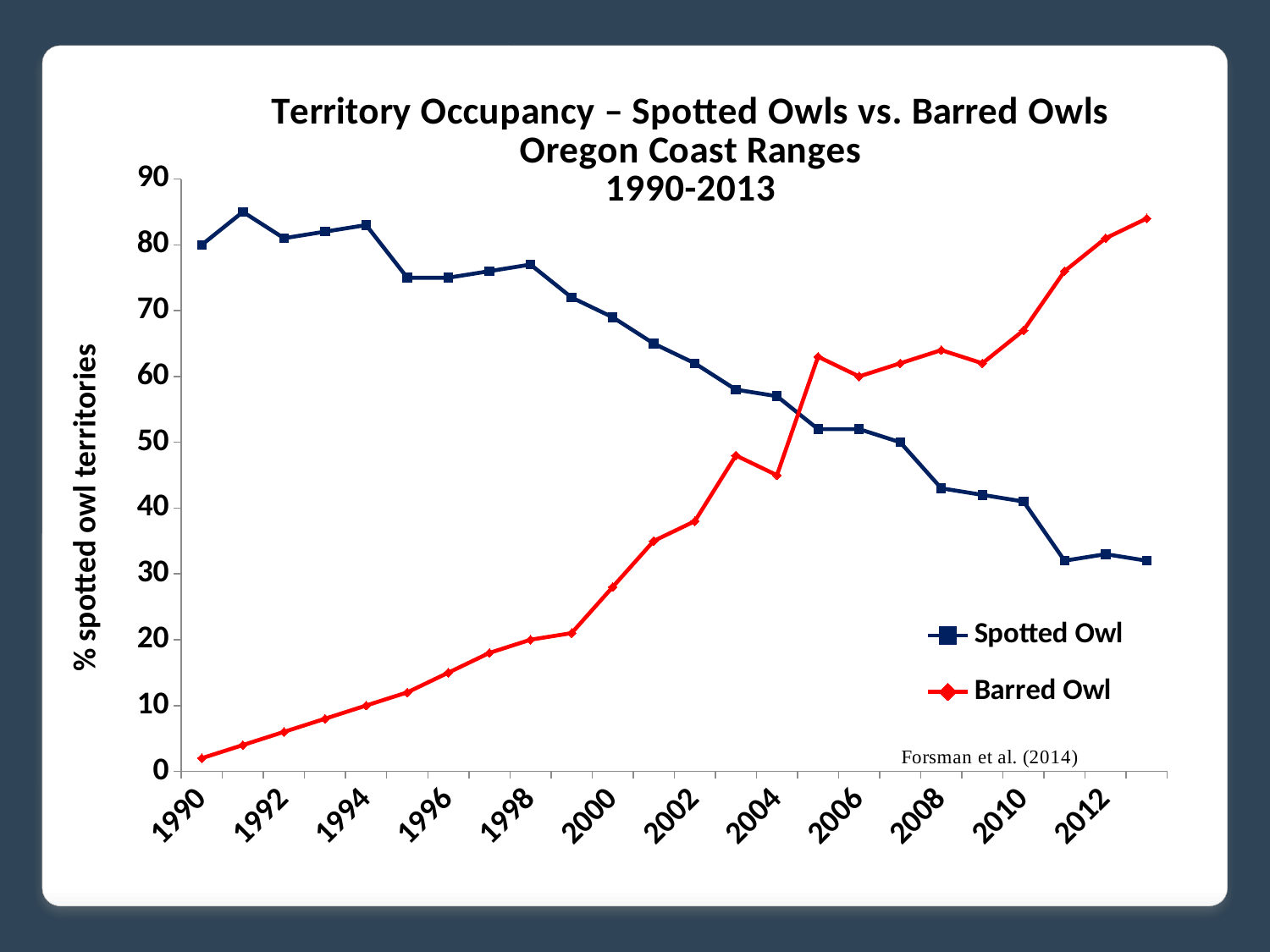
What is the title of the chart? Territory Occupancy – Spotted Owls vs. Barred Owls Oregon Coast Ranges 1990-2013 Does the Barred Owl series rise or fall from 1990 to 2013? rise Is the Barred Owl value for 1990 greater or less than 10? less Is the Barred Owl value for 2010 greater or less than 60? greater What is the label on the y axis? % spotted owl territories Is the Spotted Owl value for 2000 greater or less than 60? greater How many series does the legend list? 2 What kind of chart is shown on the slide? line chart Does the Spotted Owl series rise or fall from 1990 to 2013? fall In 2010, which series has the higher value, Spotted Owl or Barred Owl? Barred Owl In 1996, which series has the higher value, Spotted Owl or Barred Owl? Spotted Owl